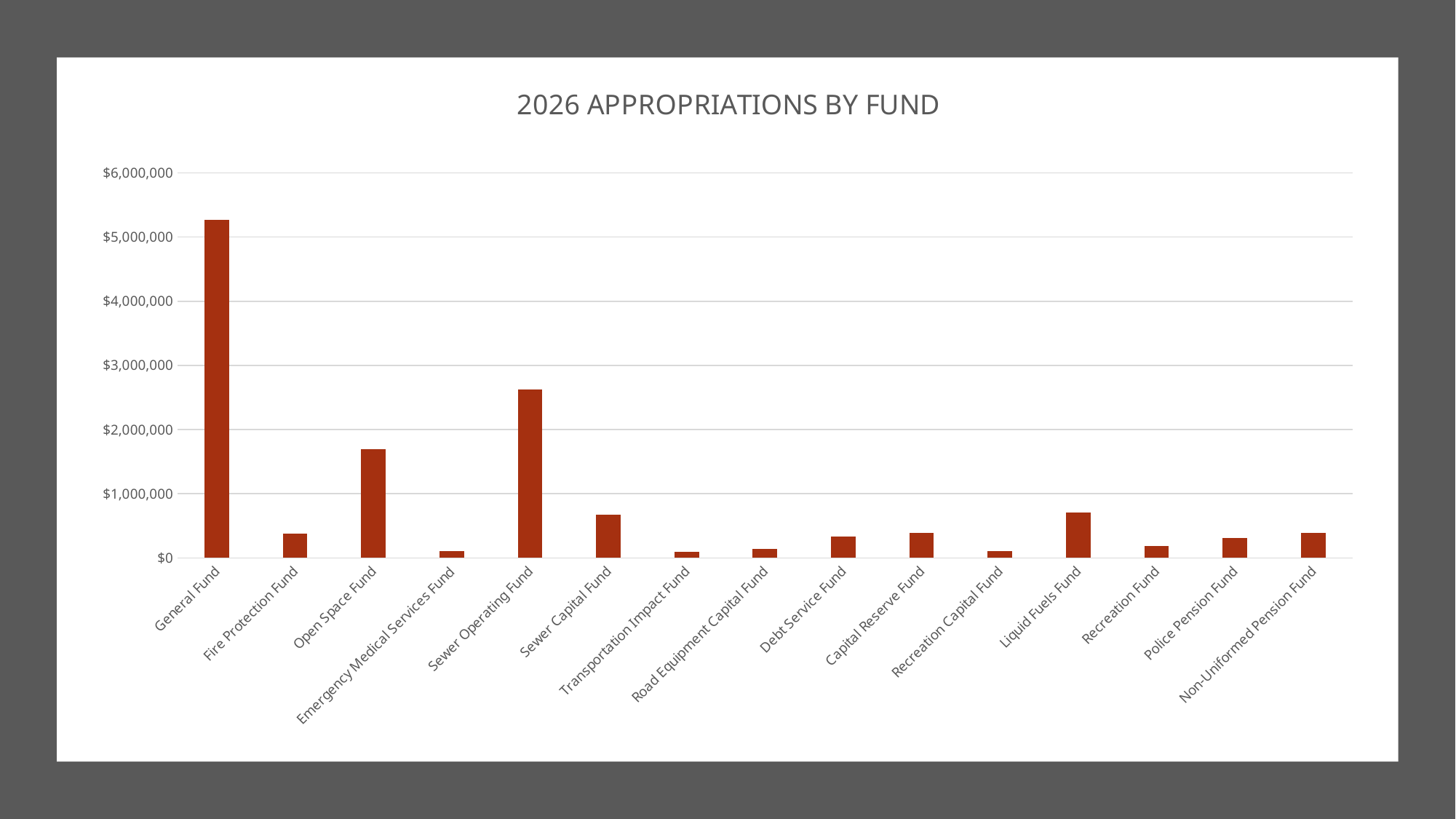
Which fund has the highest appropriation in the chart? General Fund Is the value for General Fund greater or less than $5,000,000? greater How many funds are shown on the x axis of the chart? 15 Which is larger, the value for Open Space Fund or the value for Sewer Operating Fund? Sewer Operating Fund Which is larger, the value for Liquid Fuels Fund or the value for Debt Service Fund? Liquid Fuels Fund Is the value for Sewer Capital Fund greater or less than $1,000,000? less What kind of chart is shown on the slide? Bar chart Is the value for Sewer Operating Fund greater or less than $2,000,000? greater Which is larger, the value for Fire Protection Fund or the value for Sewer Capital Fund? Sewer Capital Fund What is the title of the chart? 2026 APPROPRIATIONS BY FUND